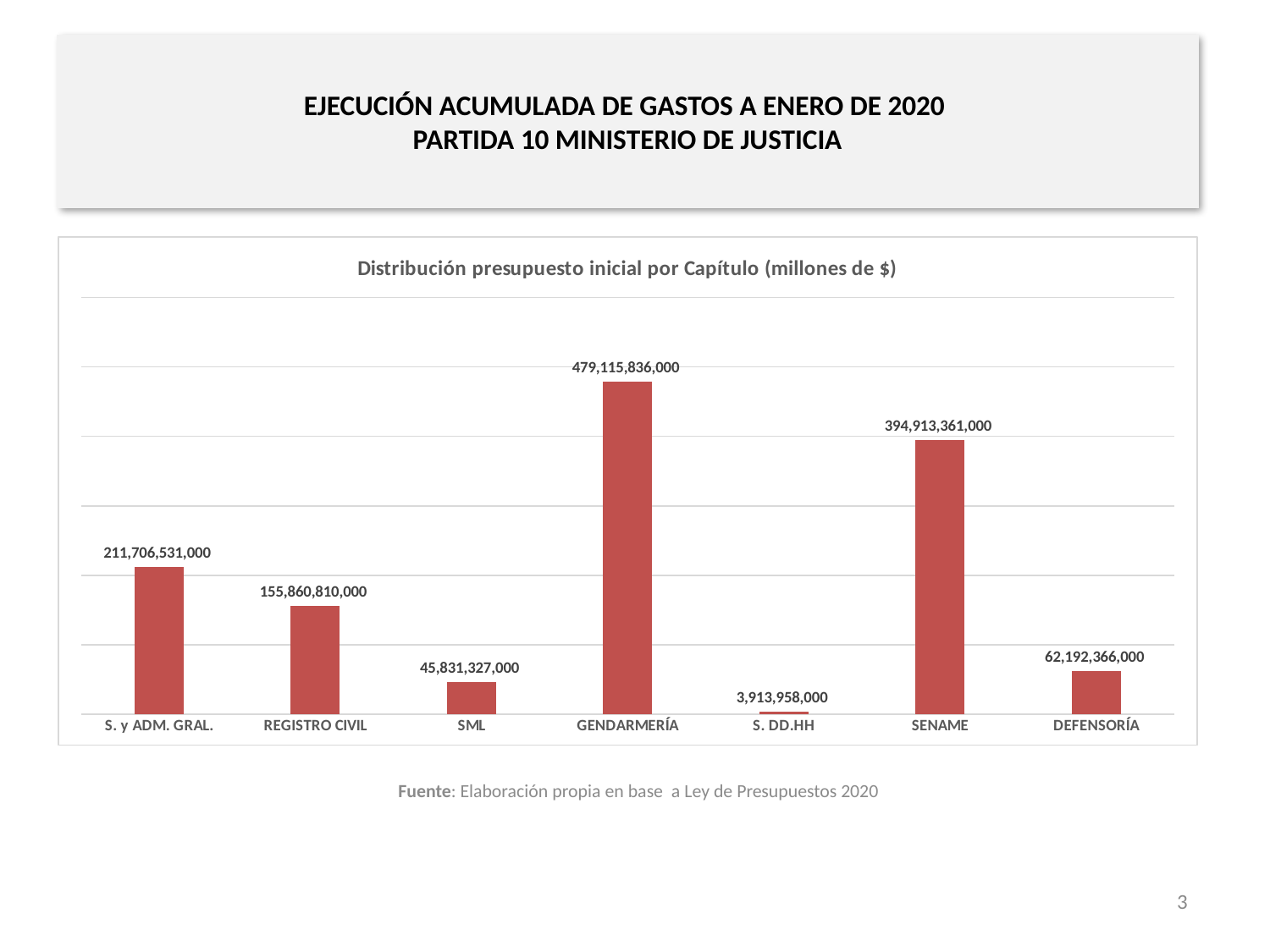
What is the difference between the values for GENDARMERÍA and SENAME? 84,202,475,000 What kind of chart is shown on the slide? Bar chart What is the value for S. DD.HH? 3,913,958,000 What is the value for SENAME? 394,913,361,000 How many categories are shown on the x axis? 7 What is the difference between the values for S. y ADM. GRAL. and REGISTRO CIVIL? 55,845,721,000 Which is larger, the value for DEFENSORÍA or the value for SML? DEFENSORÍA Which category has the lowest value? S. DD.HH What is the value for GENDARMERÍA? 479,115,836,000 What is the title of the chart? Distribución presupuesto inicial por Capítulo (millones de $) What is the value for REGISTRO CIVIL? 155,860,810,000 Which category has the highest value? GENDARMERÍA